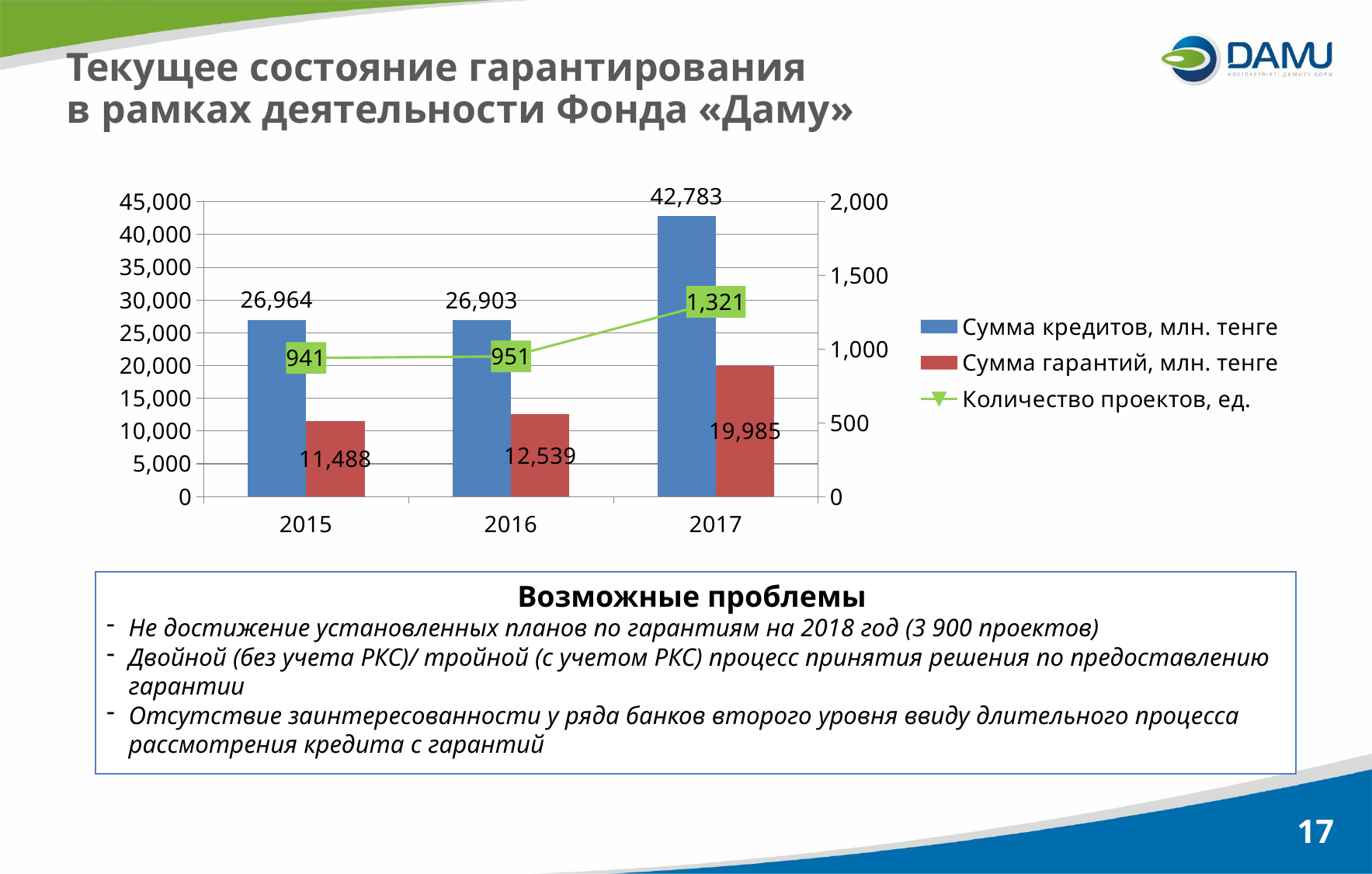
In which year is Сумма кредитов, млн. тенге the highest? 2017 What is the difference between Сумма гарантий, млн. тенге in 2017 and 2016? 7,446 How many series does the legend list? 3 Which series is plotted as a line with markers rather than bars? Количество проектов, ед. What is the value of Сумма гарантий, млн. тенге for 2015? 11,488 How many years are shown on the x axis of the chart? 3 In which year is Сумма гарантий, млн. тенге the lowest? 2015 Which is larger: Сумма кредитов, млн. тенге in 2015 or in 2016? 2015 What is the value of Количество проектов, ед. for 2016? 951 What is the value of Сумма кредитов, млн. тенге for 2017? 42,783 Is the value of Сумма гарантий, млн. тенге for 2017 greater or less than 15,000? greater Does Сумма гарантий, млн. тенге rise or fall from 2015 to 2017? rise